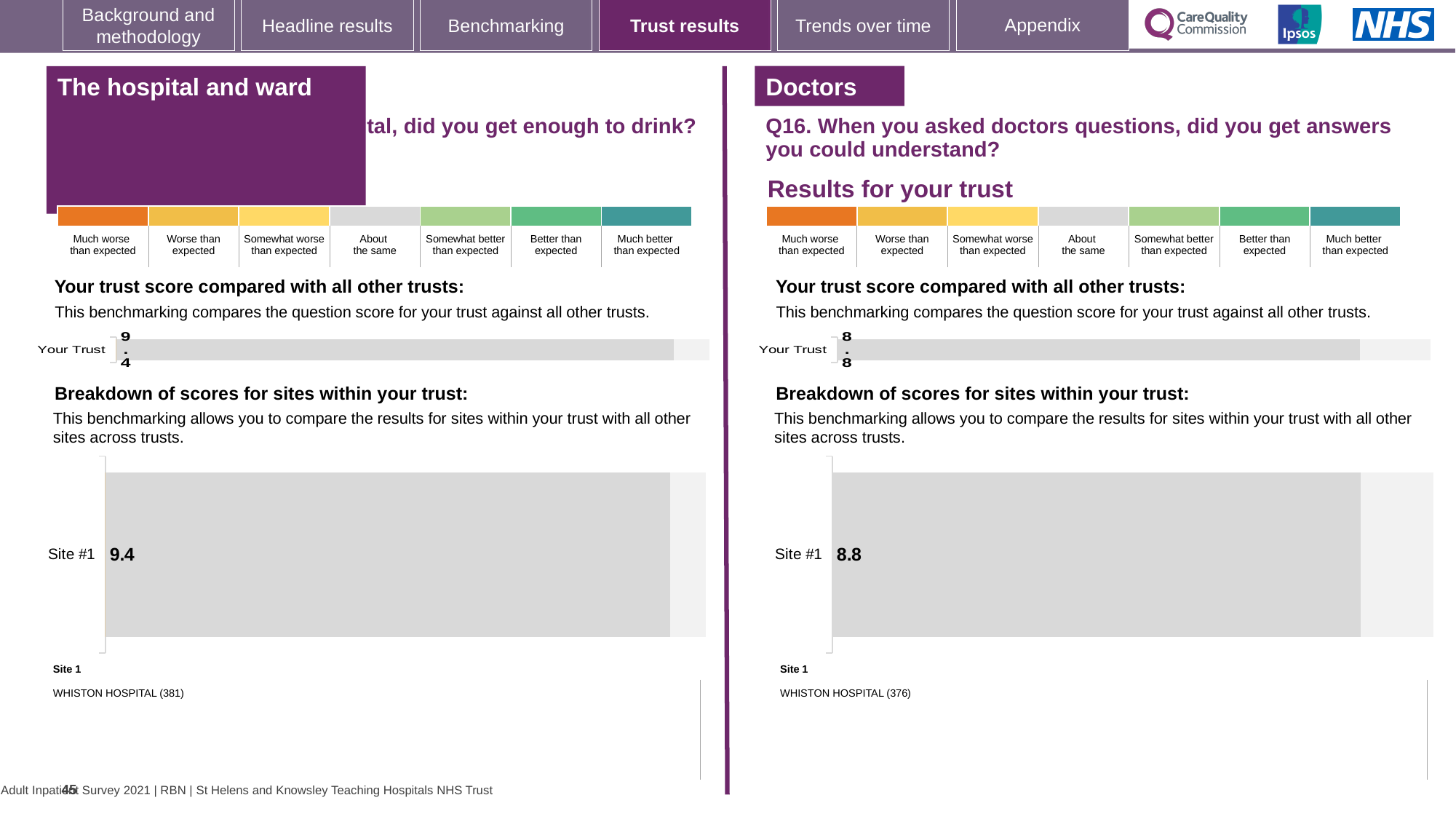
How many sites are shown in the 'Breakdown of scores for sites within your trust' chart in the right panel (Doctors, Q16)? 1 How many sites are shown in the 'Breakdown of scores for sites within your trust' chart in the left panel (The hospital and ward)? 1 In the right panel (Doctors, Q16), which hospital is listed as Site 1 below the site breakdown chart? WHISTON HOSPITAL (376) In the left panel (The hospital and ward), which hospital is listed as Site 1 below the site breakdown chart? WHISTON HOSPITAL (381) Which is larger: the Your Trust score in the left panel (The hospital and ward) or the Your Trust score in the right panel (Doctors, Q16)? The left panel (The hospital and ward), 9.4 In the right panel (Doctors, Q16), what is the value shown for Your Trust in the 'Your trust score compared with all other trusts' chart? 8.8 What type of chart is used for the 'Breakdown of scores for sites within your trust' in the left panel (The hospital and ward)? Bar chart In the right panel (Doctors, Q16), what score is shown for Site #1 in the 'Breakdown of scores for sites within your trust' chart? 8.8 In the left panel (The hospital and ward), what score is shown for Site #1 in the 'Breakdown of scores for sites within your trust' chart? 9.4 In the left panel (The hospital and ward), what is the value shown for Your Trust in the 'Your trust score compared with all other trusts' chart? 9.4 What type of chart is used to show the Your Trust score in the right panel (Doctors, Q16)? Bar chart What is the difference between the Site #1 score in the left panel (9.4) and the Site #1 score in the right panel (8.8)? 0.6